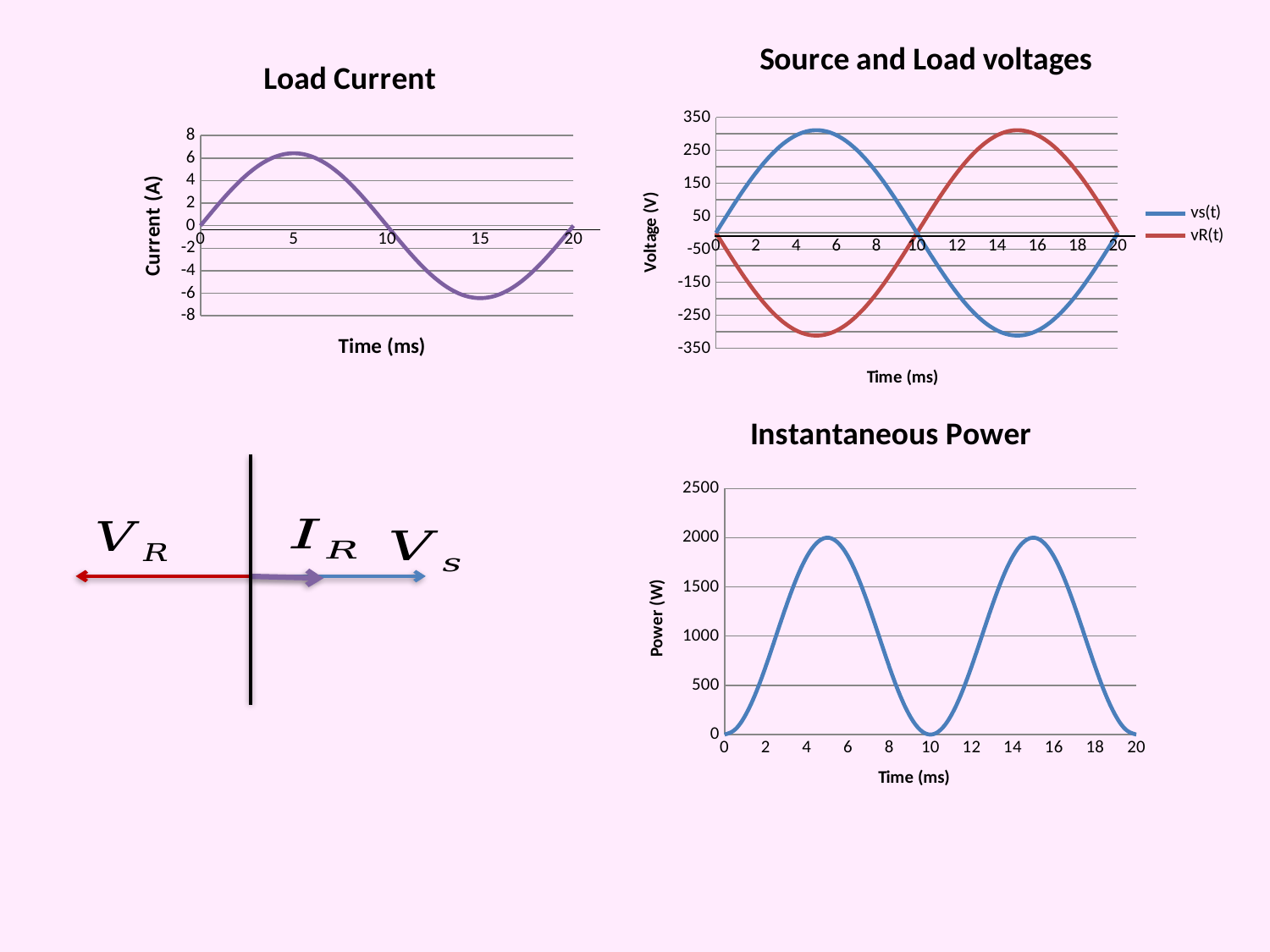
On the Load Current chart, is the current at 5 ms greater or less than 4? greater On the Source and Load voltages chart, which series has the larger value at 15 ms, vs(t) or vR(t)? vR(t) On the Source and Load voltages chart, is the value of vR(t) at 5 ms greater or less than -250? less On the Load Current chart, does the current rise or fall between 5 ms and 15 ms? fall What are the two legend entries on the Source and Load voltages chart? vs(t) and vR(t) What kind of chart is the Load Current chart? line chart How many series does the legend of the Source and Load voltages chart list? 2 What is the y-axis label of the Load Current chart? Current (A) On the Source and Load voltages chart, is the value of vs(t) at 5 ms greater or less than 250? greater On the Instantaneous Power chart, what is the maximum value reached by the curve? 2000 On the Instantaneous Power chart, what is the power value at 10 ms? 0 On the Instantaneous Power chart, does the power rise or fall between 0 ms and 5 ms? rise